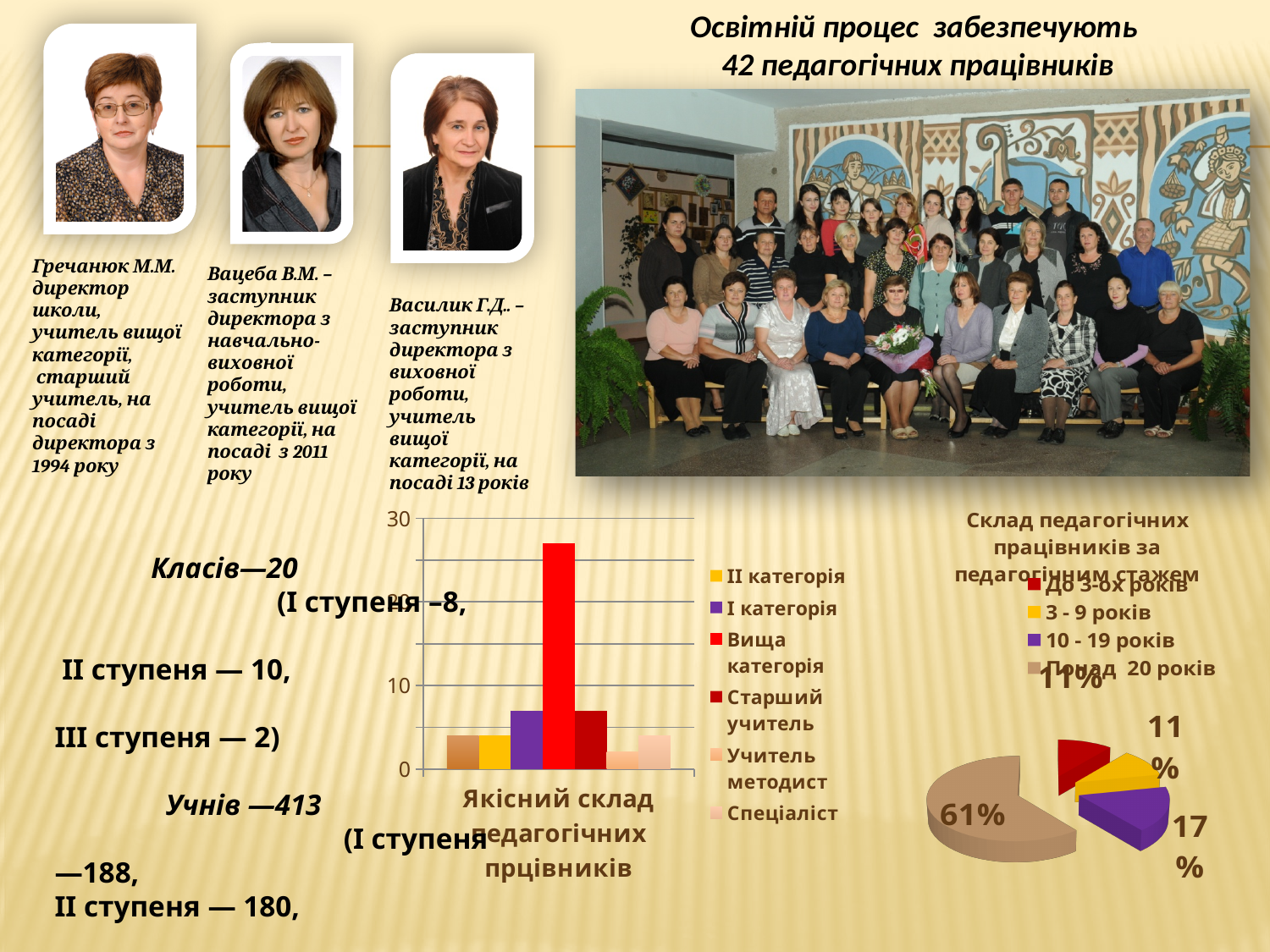
What kind of chart is the chart titled 'Склад педагогічних працівників за педагогічним стажем'? Pie chart On the bar chart 'Якісний склад педагогічних прцівників', how many series does the legend list? 6 On the pie chart 'Склад педагогічних працівників за педагогічним стажем', what share is shown for 'Понад 20 років'? 61% On the pie chart 'Склад педагогічних працівників за педагогічним стажем', what share is shown for '10 - 19 років'? 17% What kind of chart is the chart titled 'Якісний склад педагогічних прцівників'? Bar chart On the bar chart 'Якісний склад педагогічних прцівників', which is larger: 'Вища категорія' or 'І категорія'? Вища категорія On the pie chart 'Склад педагогічних працівників за педагогічним стажем', which category has the largest slice? Понад 20 років On the bar chart 'Якісний склад педагогічних прцівників', which series has the tallest bar? Вища категорія On the pie chart 'Склад педагогічних працівників за педагогічним стажем', how many categories does the legend list? 4 On the bar chart 'Якісний склад педагогічних прцівників', is the value for 'ІІ категорія' greater or less than 10? less On the pie chart 'Склад педагогічних працівників за педагогічним стажем', what is the difference between the shares for 'Понад 20 років' and '10 - 19 років'? 44% On the bar chart 'Якісний склад педагогічних прцівників', is the value for 'Вища категорія' greater or less than 20? greater